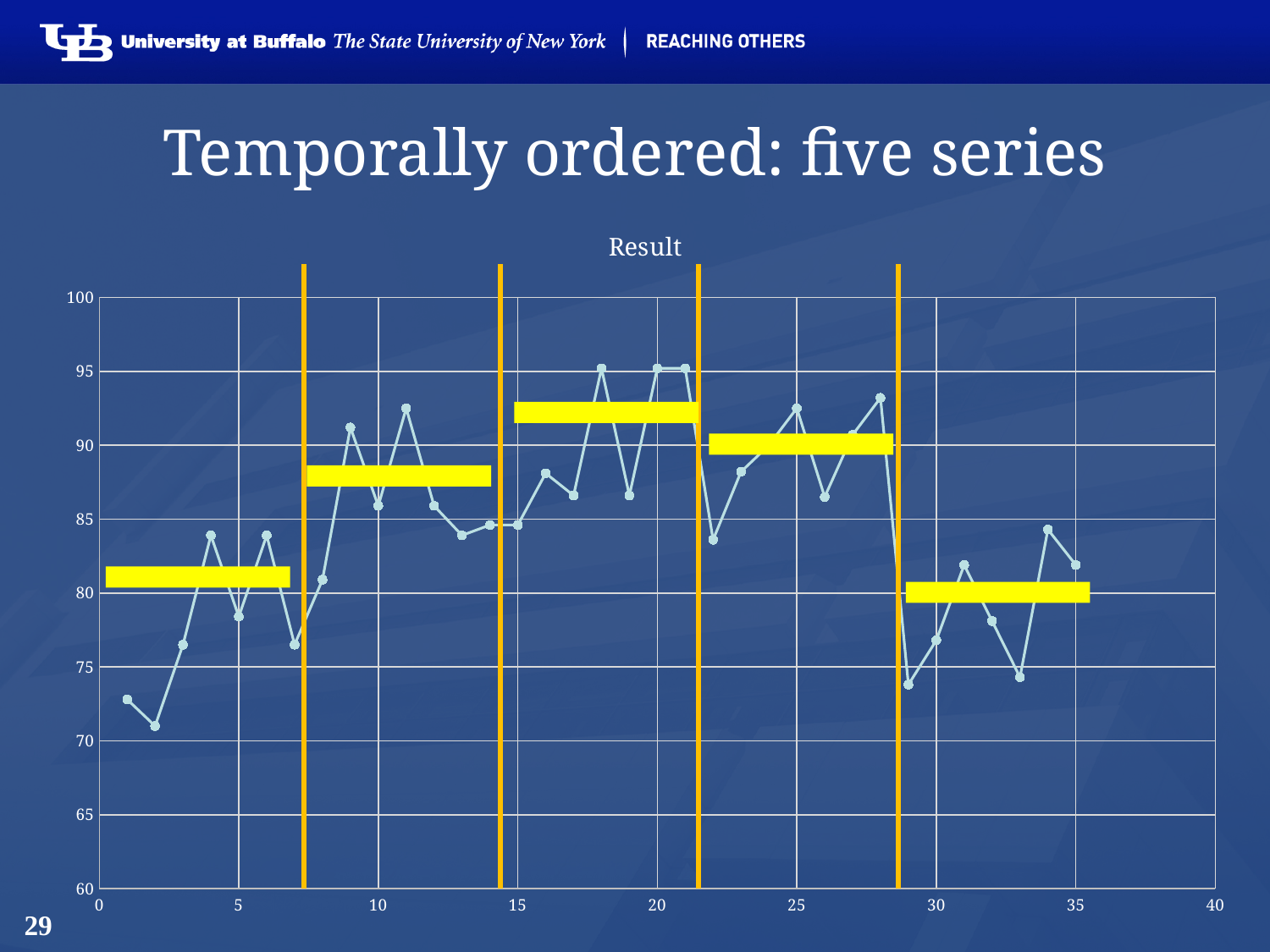
Is the value at x = 18 greater or less than 90? greater What is the title of the chart? Result Between x = 15 and x = 21, do the values generally rise or fall? rise What is the lowest value shown on the y axis? 60 Which is larger, the value at x = 11 or the value at x = 33? x = 11 Is the value at x = 2 greater or less than 75? less At which x value does the lowest point of the line occur? 2 What kind of chart is shown on the slide? line chart Is the value at x = 22 greater or less than 85? less What is the highest value shown on the y axis? 100 How many vertical orange divider lines are drawn on the chart? 4 How many yellow horizontal bars are drawn on the chart? 5